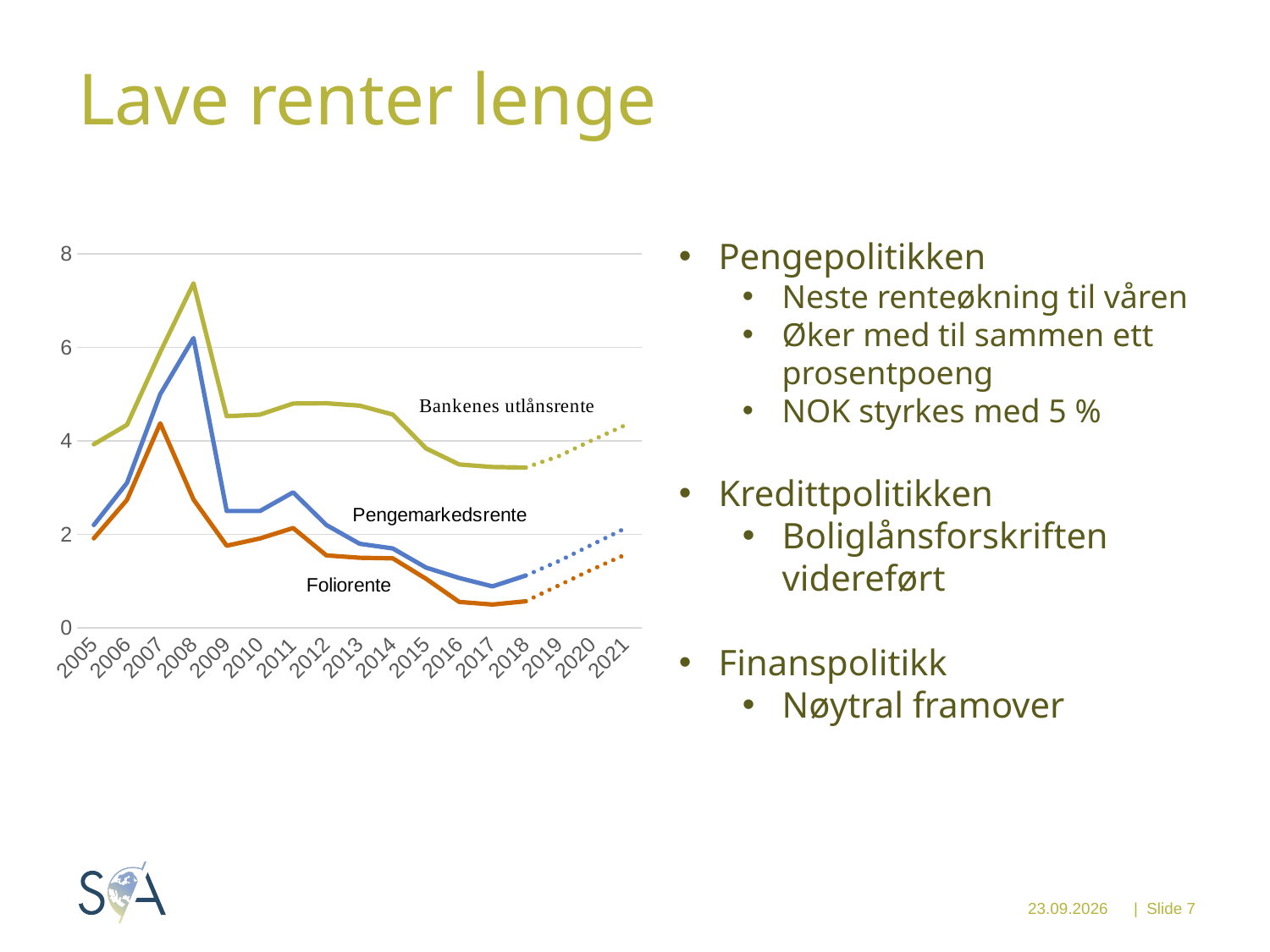
Which series has the lowest values across the chart? Foliorente Is the value for Foliorente in 2016 greater or less than 1? less Do the values for Foliorente rise or fall from 2008 to 2009? fall In which year does Foliorente reach its highest value? 2007 Is the value for Bankenes utlånsrente in 2008 greater or less than 6? greater What kind of chart is shown on the slide? line chart In which year does Pengemarkedsrente reach its highest value? 2008 How many series are plotted in the chart? 3 How many years are shown on the x axis of the chart? 17 In 2008, which is larger: Bankenes utlånsrente or Foliorente? Bankenes utlånsrente Is the value for Bankenes utlånsrente in 2017 greater or less than 4? less In which year does Bankenes utlånsrente reach its highest value? 2008